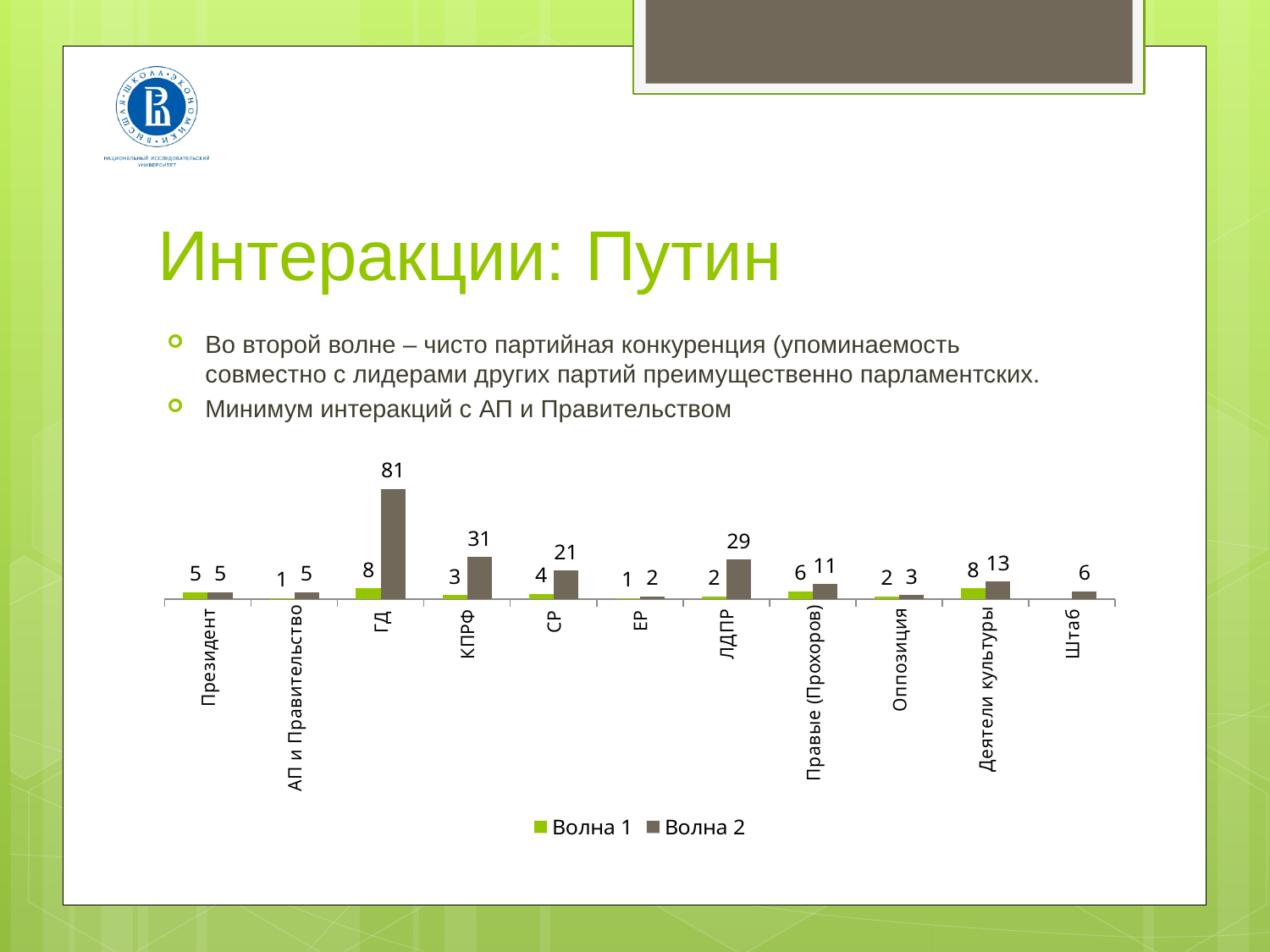
How many series does the legend list? 2 What is the Волна 1 value for Деятели культуры? 8 What is the Волна 2 value for ЛДПР? 29 Which category has the highest Волна 2 value? ГД How many categories are shown on the x axis? 11 What is the difference between the Волна 2 values for ГД and КПРФ? 50 What is the Волна 2 value for ГД? 81 Which is larger: the Волна 2 value for СР or the Волна 2 value for ЛДПР? ЛДПР What kind of chart is shown on the slide? Bar chart What are the names of the two series in the legend? Волна 1 and Волна 2 What is the Волна 1 value for Правые (Прохоров)? 6 What is the difference between the Волна 2 and Волна 1 values for КПРФ? 28